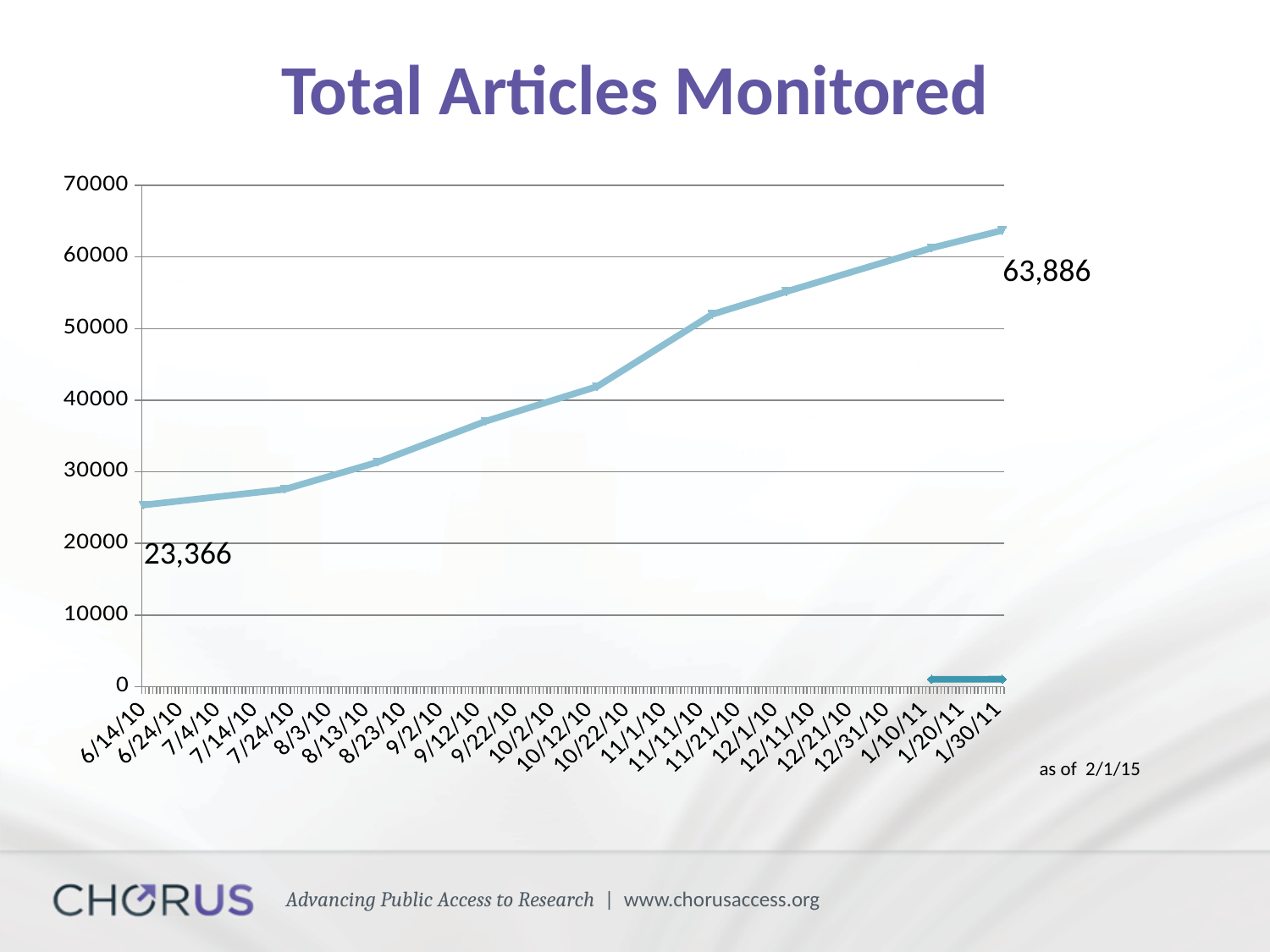
What is the difference between the last labelled value (63,886) and the first labelled value (23,366)? 40,520 Is the value at 1/30/11 larger or smaller than the value at 6/14/10? larger Is the value for 9/12/10 greater or less than 30000? greater Is the value for 7/14/10 greater or less than 30000? less What kind of chart is shown on the slide? line chart Do the values rise or fall from left to right along the x axis? rise Is the value for 12/1/10 greater or less than 50000? greater What is the title of the chart? Total Articles Monitored What is the value of the last data label on the chart, at 1/30/11? 63,886 What is the value of the first data label on the chart, at 6/14/10? 23,366 Which date has the lowest number of total articles monitored? 6/14/10 Which date has the highest number of total articles monitored? 1/30/11